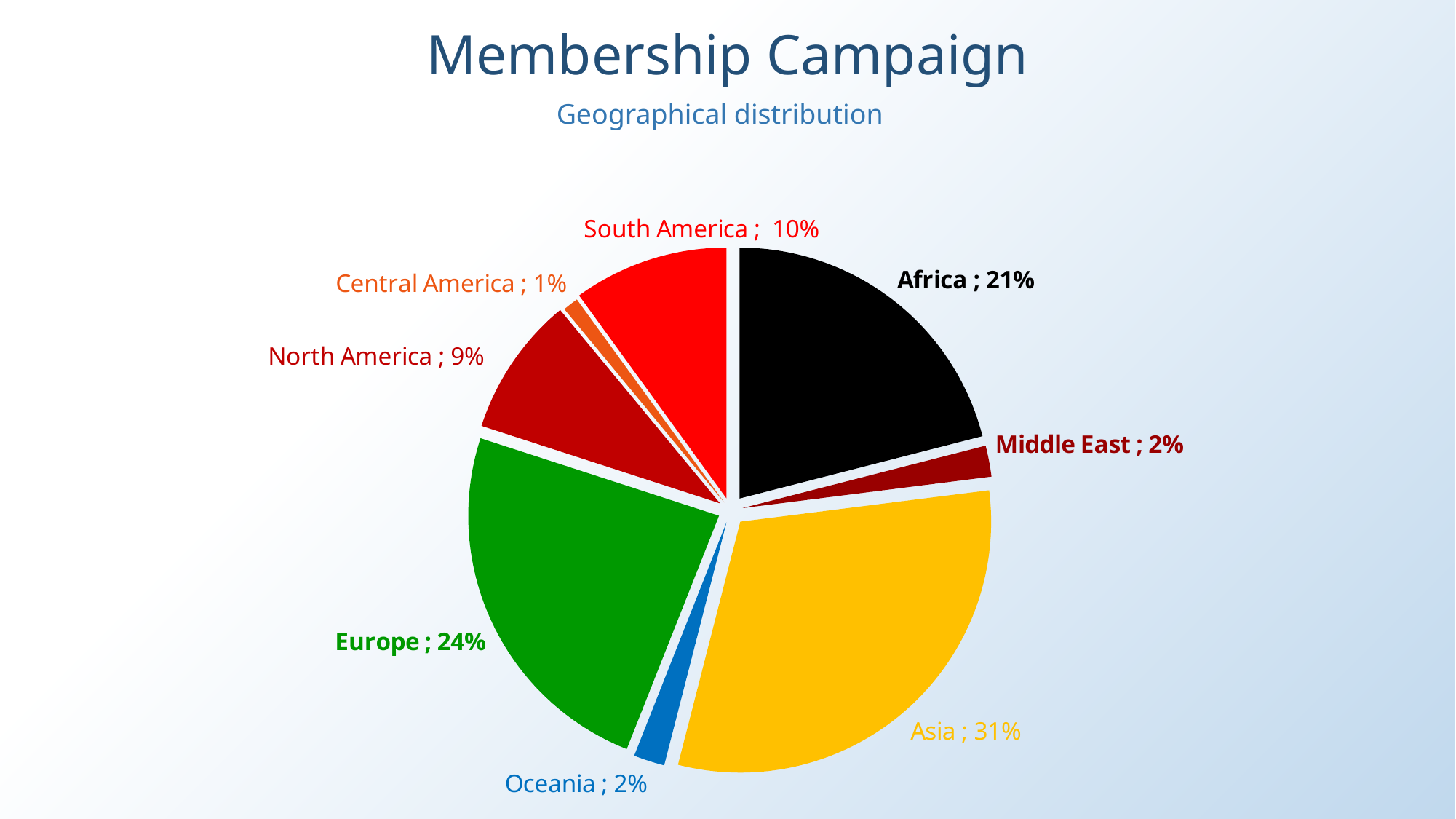
What is the difference in percentage points between Europe and South America? 14 Which region has the largest slice of the pie? Asia Which is larger, the share for Africa or the share for Europe? Europe What is the value labelled for North America? 9% What share of the pie does Asia account for? 31% What percentage is shown for Europe? 24% What is the title of the chart on the slide? Membership Campaign What type of chart is shown on the slide? Pie chart How many regions are shown in the pie chart? 8 What percentage is shown for Central America? 1% What is the difference in percentage points between Asia and Africa? 10 Which region has the smallest slice of the pie? Central America